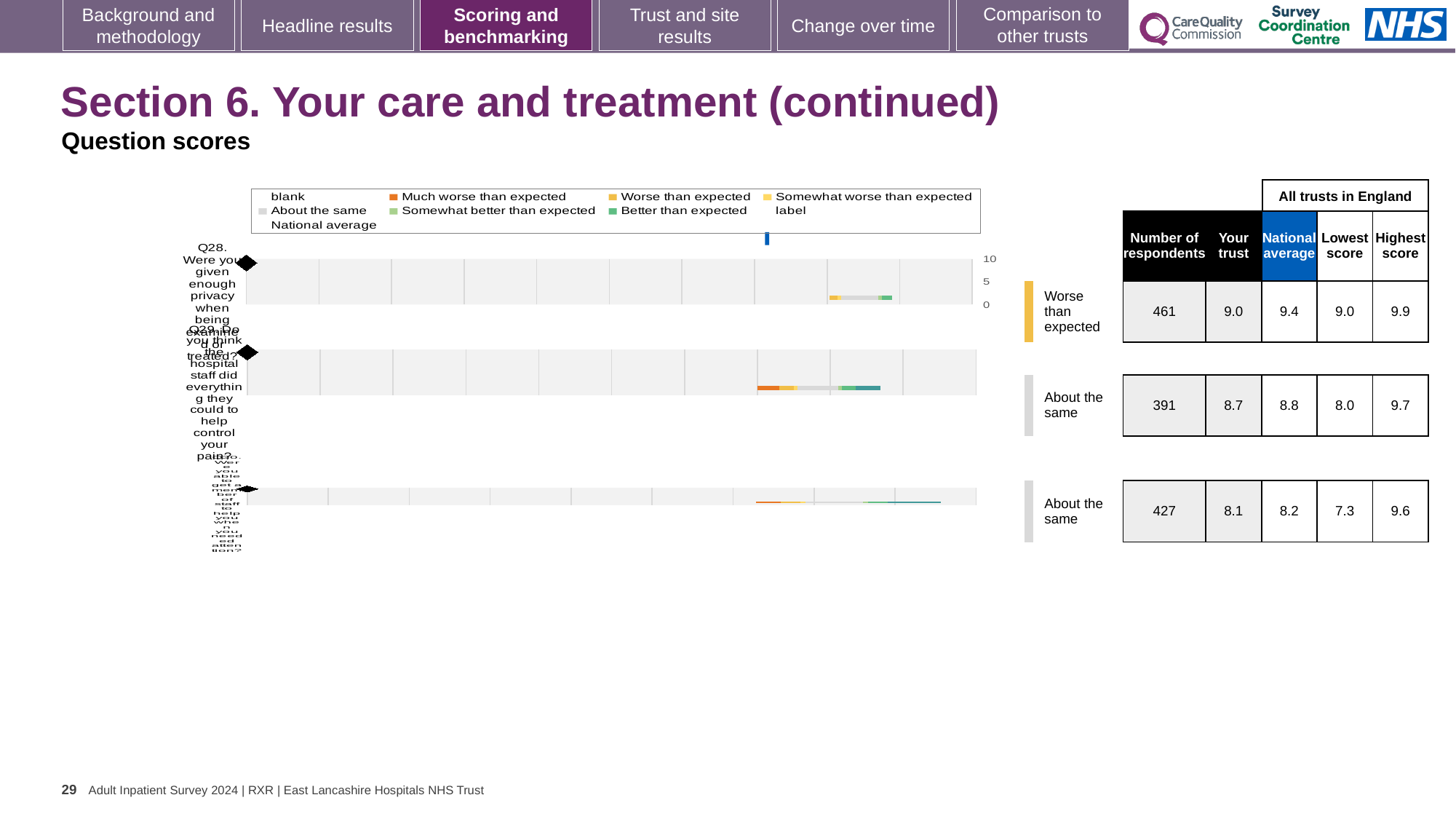
How many questions (rows) are plotted in the chart? 3 Which row has the highest number of respondents? Q28 (461) For Q29 (the second row), which is larger: the 'Your trust' score or the national average? National average What benchmark category is shown next to Q28 (the first row)? Worse than expected In the table, what is the national average for Q28 (the first row)? 9.4 Which row has the lowest 'Your trust' score? The third row (8.1) What colour does the legend use for 'Much worse than expected'? Orange What kind of chart is used to show the question scores on this slide? Bar chart For Q28 (the first row), what is the difference between the highest score and the lowest score? 0.9 How many respondents are listed for Q29 (the second row)? 391 What is the highest score listed for the third row of the table? 9.6 In the table, what is the 'Your trust' score for Q28 (the first row)? 9.0